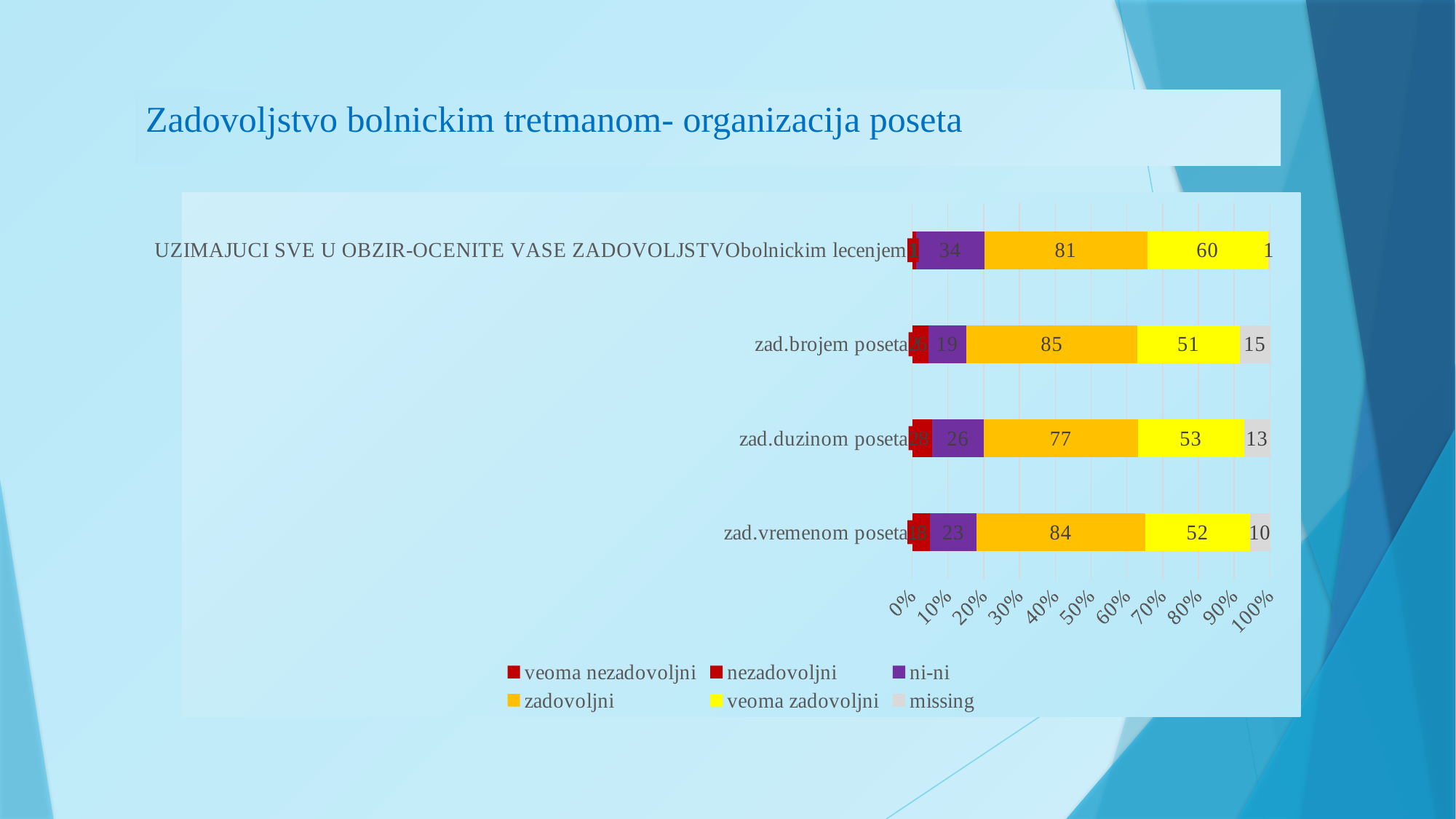
Which category has the lowest 'ni-ni' value? zad.brojem poseta Which has the larger 'zadovoljni' value: 'zad.duzinom poseta' or 'zad.vremenom poseta'? zad.vremenom poseta How many categories (bars) are plotted in the chart? 4 What is the value of the 'veoma zadovoljni' segment for 'bolnickim lecenjem'? 60 Which category has the highest 'zadovoljni' value? zad.brojem poseta What colour represents the 'missing' series in the legend? Light grey How many series does the legend list? 6 What is the value of the 'missing' segment for 'zad.duzinom poseta'? 13 What is the value of the 'ni-ni' segment for 'zad.vremenom poseta'? 23 What is the difference between the 'veoma zadovoljni' values for 'bolnickim lecenjem' and 'zad.brojem poseta'? 9 What is the value of the 'zadovoljni' segment for 'zad.brojem poseta'? 85 What kind of chart is shown on the slide? Stacked bar chart